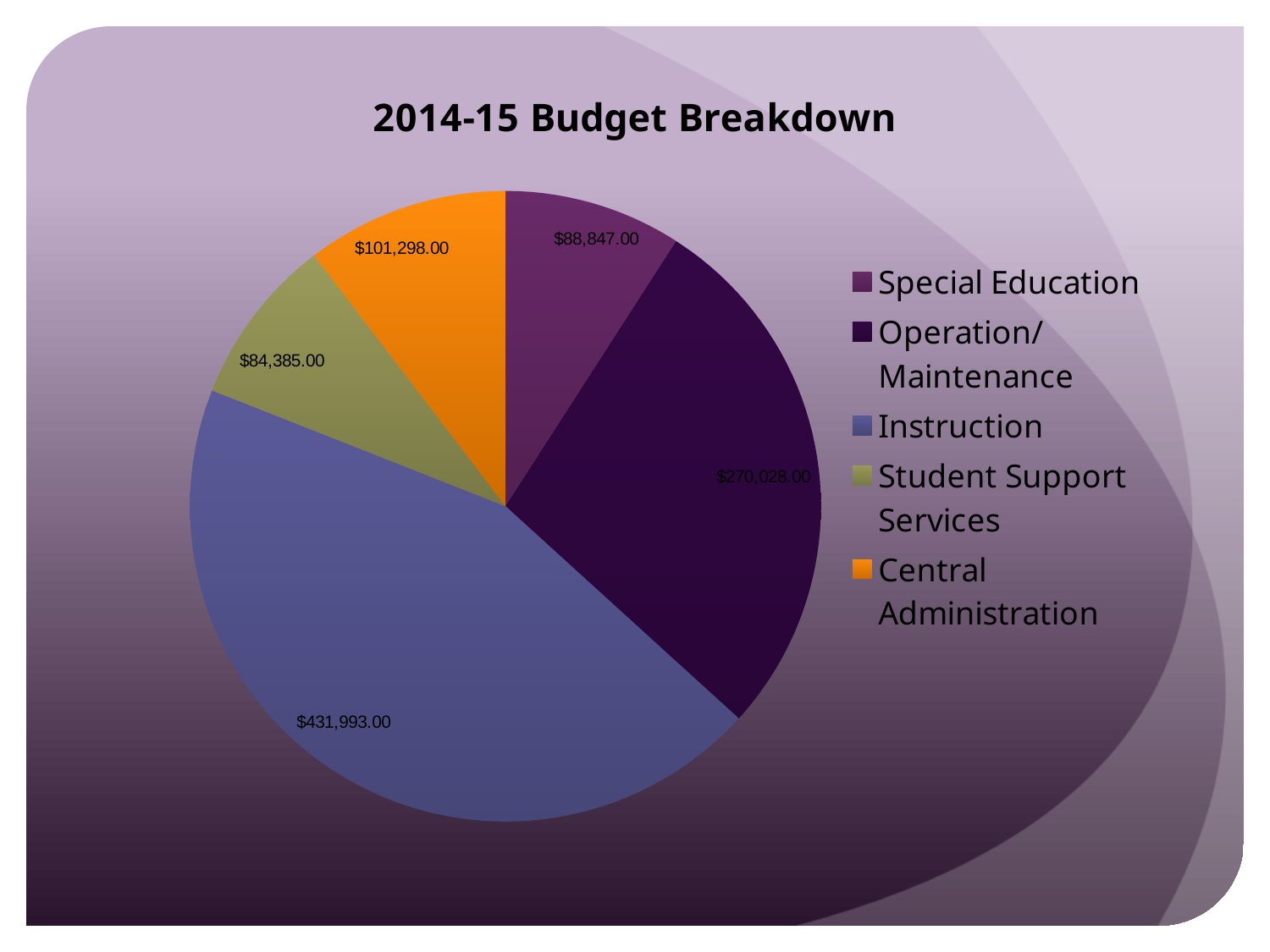
Which is larger, Special Education or Central Administration? Central Administration What type of chart is shown on the slide? Pie chart What is the value for Operation/Maintenance? $270,028.00 What is the value for Instruction? $431,993.00 What colour represents Central Administration in the chart? Orange What is the value for Central Administration? $101,298.00 Which category has the smallest value? Student Support Services What is the value for Student Support Services? $84,385.00 How many categories does the legend list? 5 Which category has the largest slice of the pie? Instruction What is the title of the chart? 2014-15 Budget Breakdown What is the difference between Instruction and Operation/Maintenance? $161,965.00